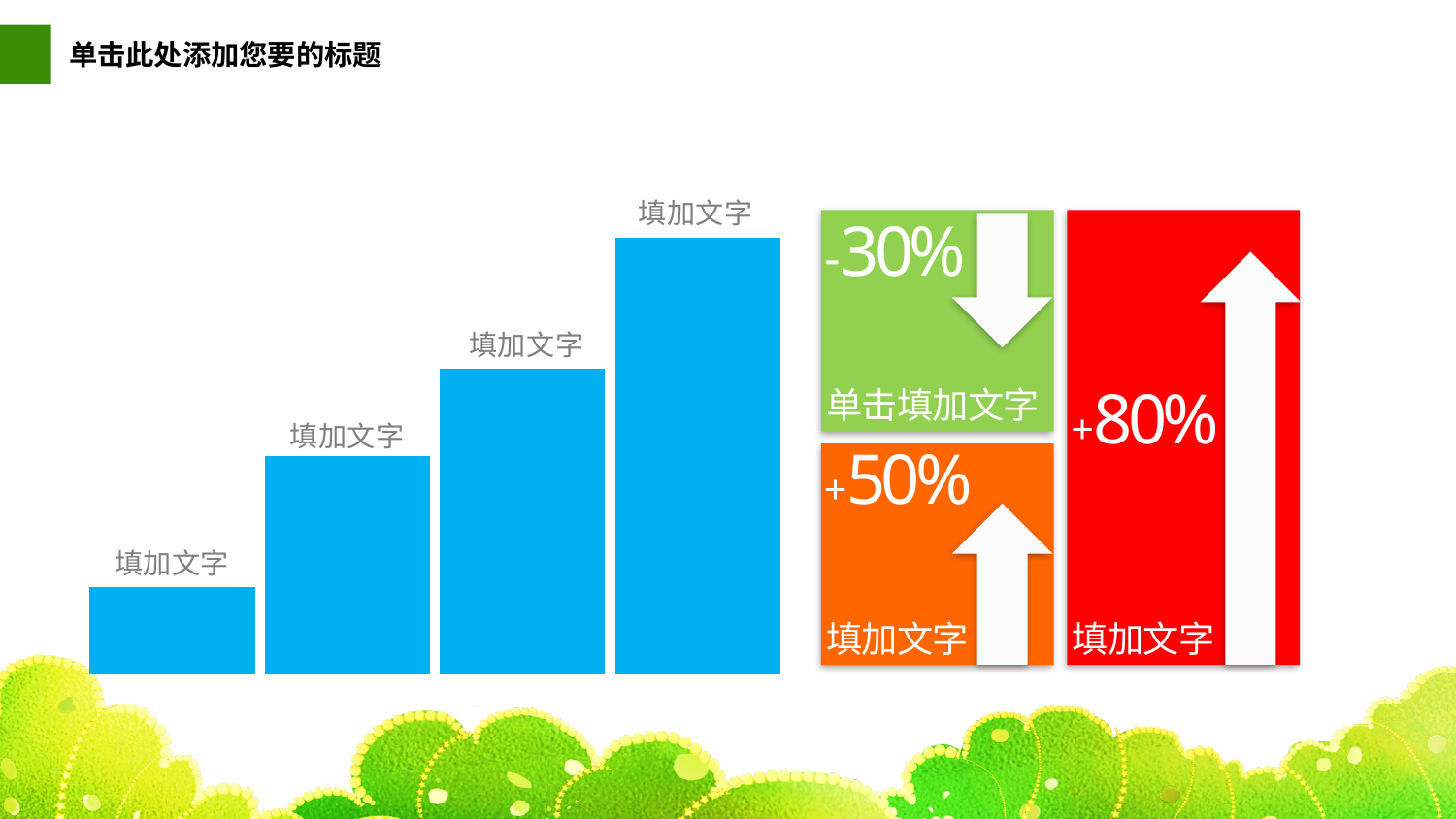
How many bars does the bar chart have? 4 What kind of chart is shown on the left of the slide? bar chart In the bar chart, is the fourth bar taller or shorter than the first bar? taller Do the bars in the bar chart rise or fall from left to right? rise Which bar in the bar chart is the tallest? the fourth (rightmost) bar Which bar in the bar chart is the shortest? the first (leftmost) bar In the bar chart, is the second bar from the left taller or shorter than the third bar? shorter What label text appears above each bar in the bar chart? 填加文字 What colour are the bars in the bar chart? blue